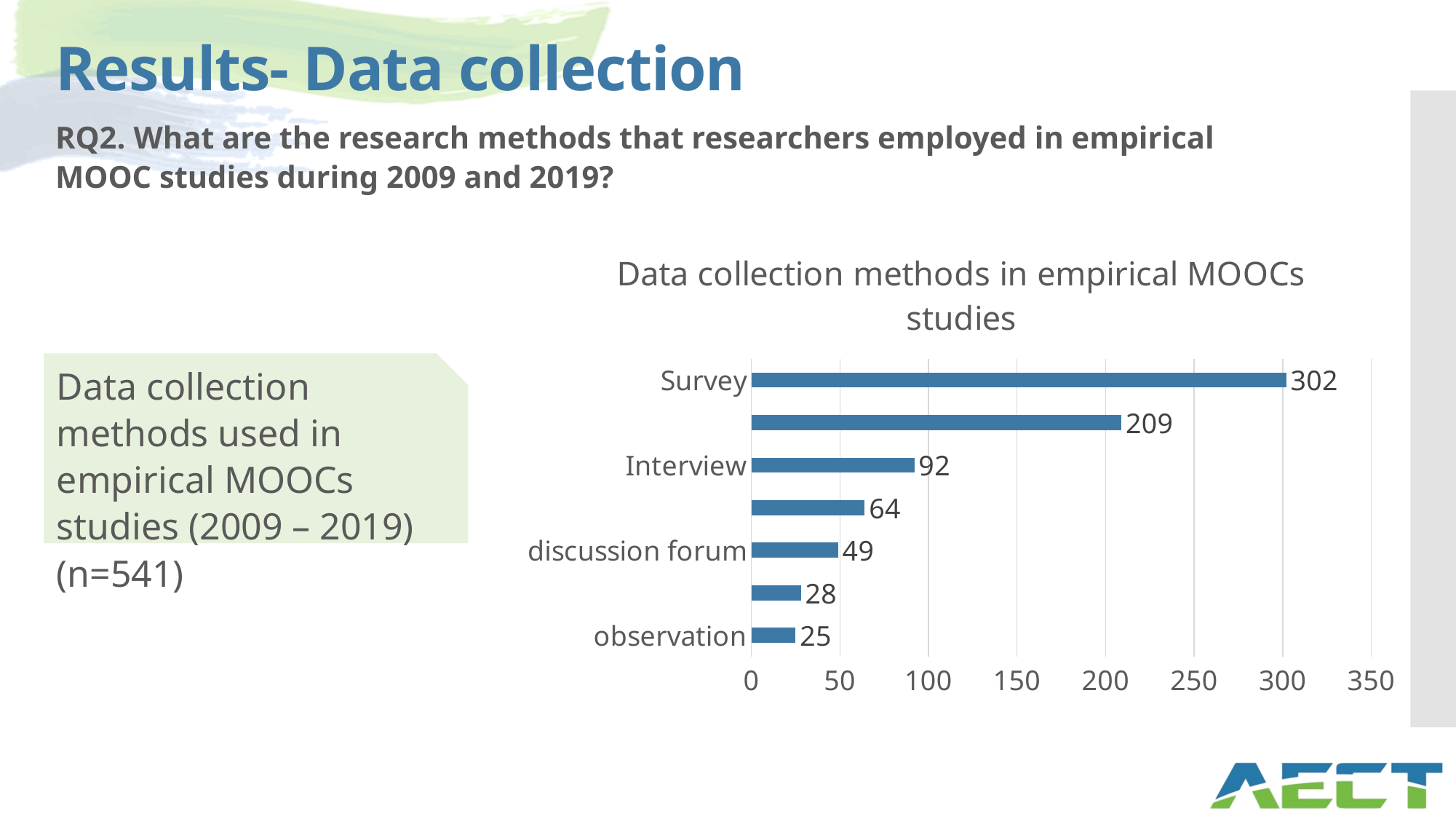
What is the difference between the values for discussion forum and observation? 24 What is the value for Interview? 92 How many bars are plotted in the chart? 7 What is the value for discussion forum? 49 What kind of chart is shown on the slide? Bar chart Which data collection method has the highest value? Survey Which is larger, the value for Interview or the value for discussion forum? Interview What is the value for observation? 25 What is the difference between the values for Survey and Interview? 210 What is the value for Survey? 302 Which data collection method has the lowest value? observation Is the value for Survey greater or less than 250? greater